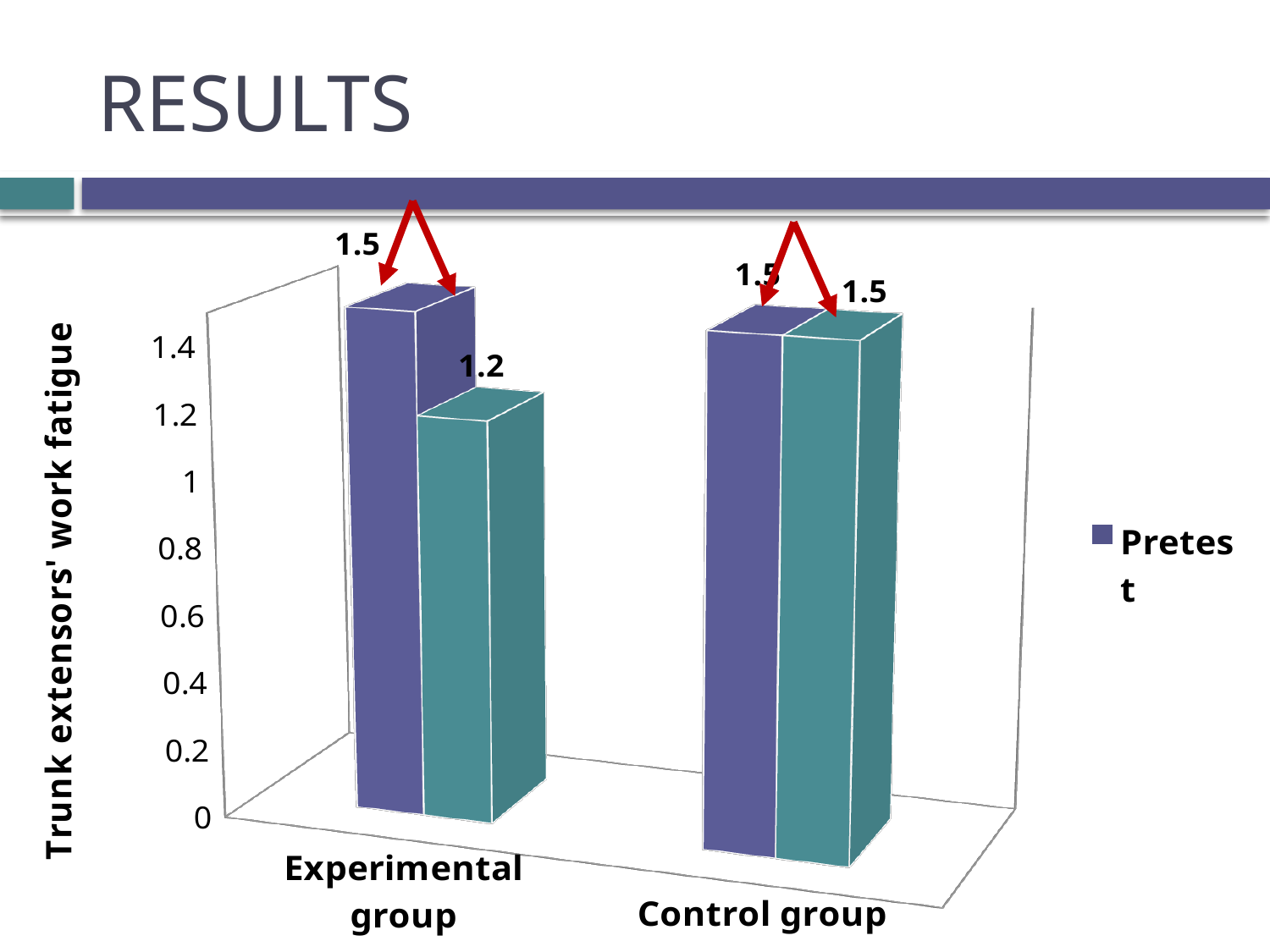
What is the label on the vertical axis of the chart? Trunk extensors' work fatigue Is the teal bar value for the Experimental group greater or less than 1.4? less What value is labelled on the teal bar for the Control group? 1.5 Which bar has the lowest value on the chart? The teal bar for the Experimental group (1.2) What is the Pretest value for the Control group? 1.5 What kind of chart is shown on the slide? Bar chart What is the difference between the teal bar values of the Control group and the Experimental group? 0.3 What is the difference between the Pretest value and the teal bar value for the Experimental group? 0.3 What value is labelled on the teal bar for the Experimental group? 1.2 What is the Pretest value for the Experimental group? 1.5 For the Experimental group, which is larger: the Pretest bar or the teal bar? Pretest How many groups (categories) are shown on the x axis? 2